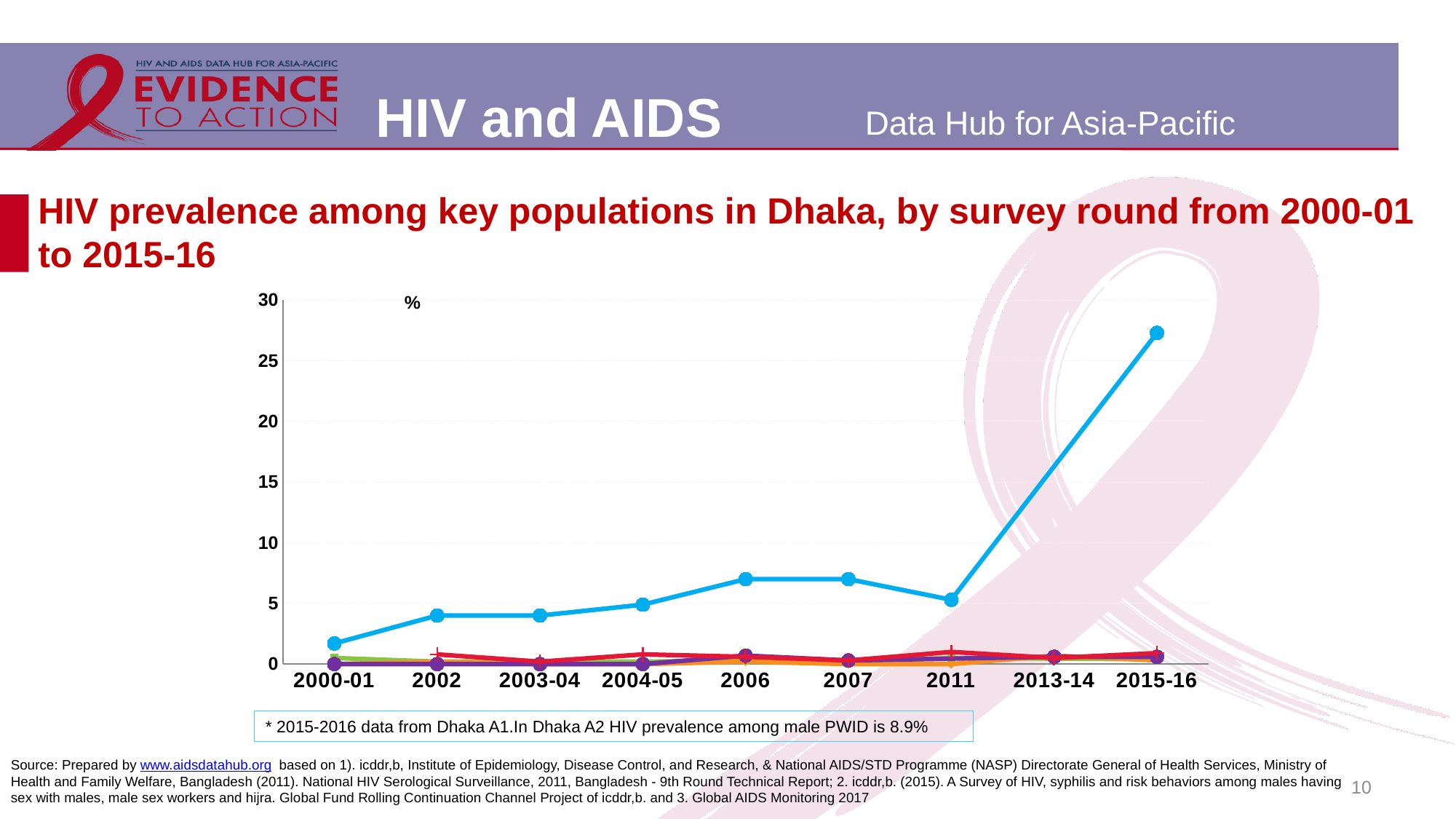
What is the first survey round shown on the x axis? 2000-01 What is the last survey round shown on the x axis? 2015-16 Is the value of the blue line in 2006 greater or less than 10? less Does the blue line rise or fall between 2011 and 2015-16? rise What is the maximum value shown on the y axis? 30 Is the value of the blue line in 2000-01 greater or less than 5? less Is the value of the blue line in 2011 greater or less than 10? less What kind of chart is shown on the slide? line chart Is the value of the blue line in 2006 larger or smaller than its value in 2002? larger How many survey rounds are shown along the x axis? 9 In which survey round does the blue (highest) line reach its peak? 2015-16